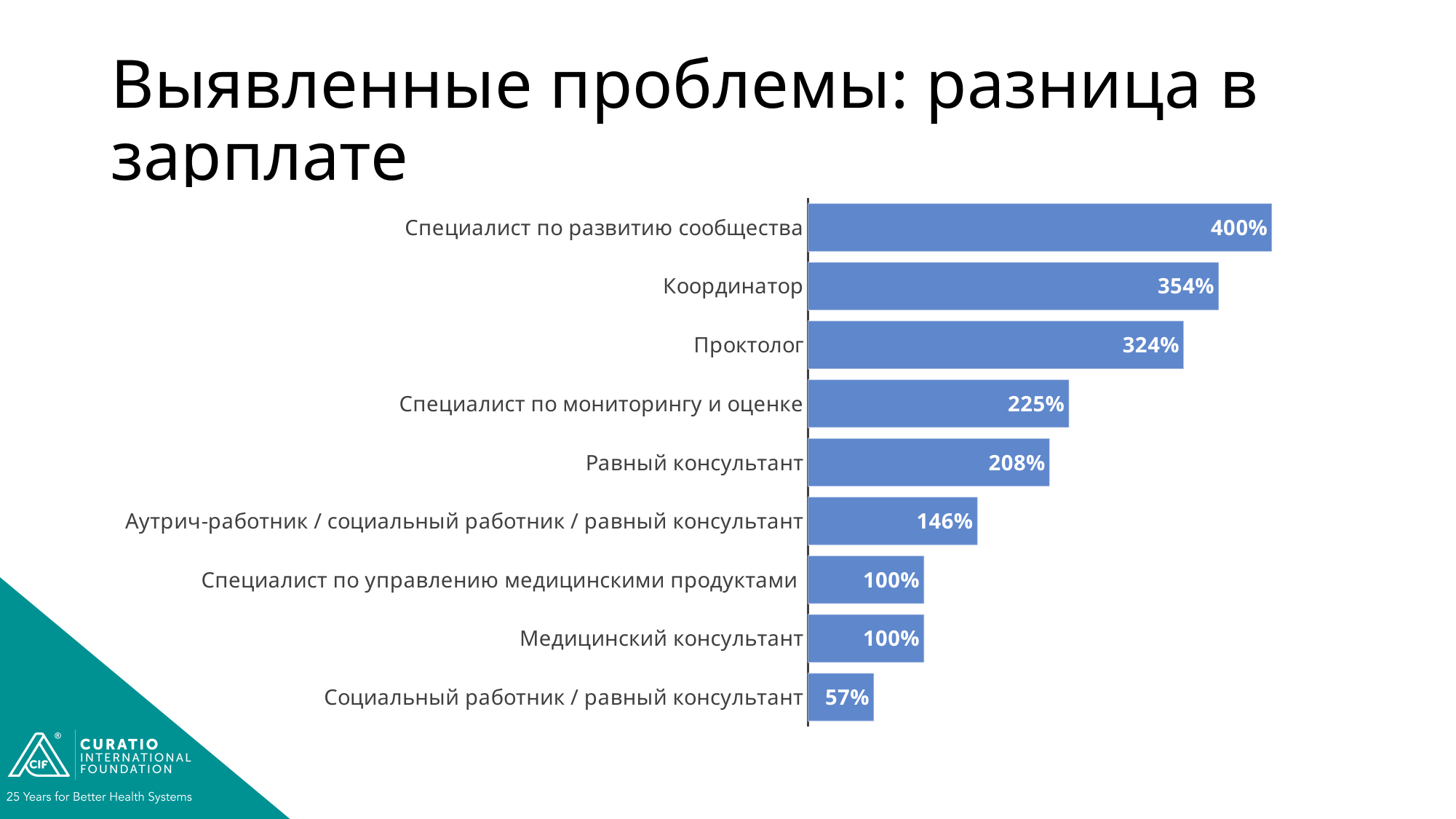
Which is larger, the value for Проктолог or the value for Специалист по мониторингу и оценке? Проктолог Which category has the lowest value? Социальный работник / равный консультант What is the value for Проктолог? 324% What is the value for Социальный работник / равный консультант? 57% What is the difference between the values for Специалист по мониторингу и оценке and Равный консультант? 17% How many categories are shown in the chart? 9 Which category has the highest value? Специалист по развитию сообщества What is the value for Координатор? 354% What is the difference between the values for Специалист по развитию сообщества and Координатор? 46% What kind of chart is shown on the slide? bar chart What is the value for Равный консультант? 208% What is the title of the slide? Выявленные проблемы: разница в зарплате